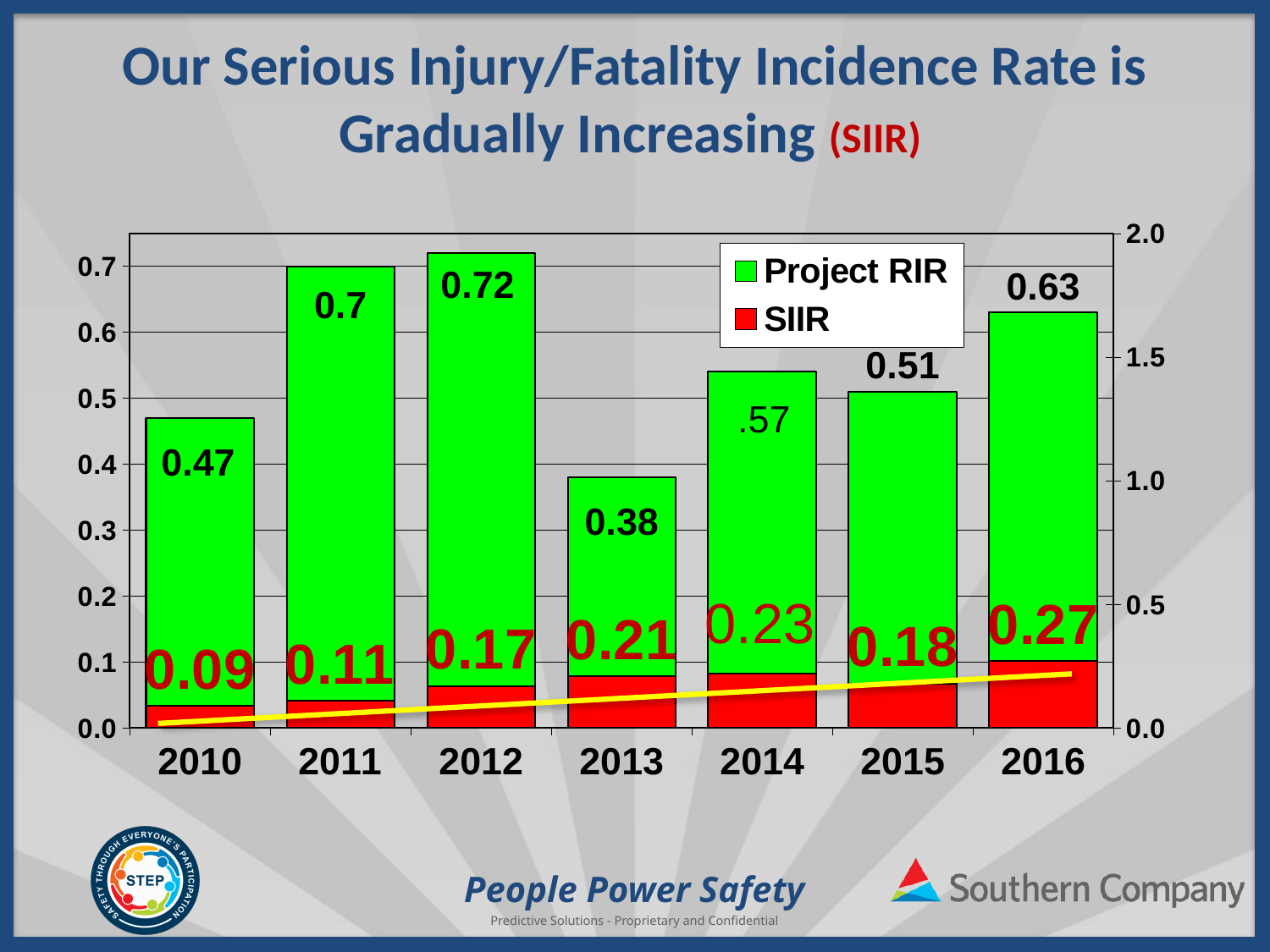
Which is larger, the SIIR value for 2014 or the SIIR value for 2015? 2014 How many years are shown on the x axis? 7 Which year has the lowest SIIR value? 2010 What kind of chart is shown on the slide? bar chart How many series does the legend list? 2 Which colour represents the SIIR series in the legend? red Which year has the highest Project RIR value? 2012 What is the Project RIR value for 2013? 0.38 What is the SIIR value for 2016? 0.27 What is the SIIR value for 2010? 0.09 What is the difference between the Project RIR values for 2011 and 2013? 0.32 What is the Project RIR value for 2012? 0.72